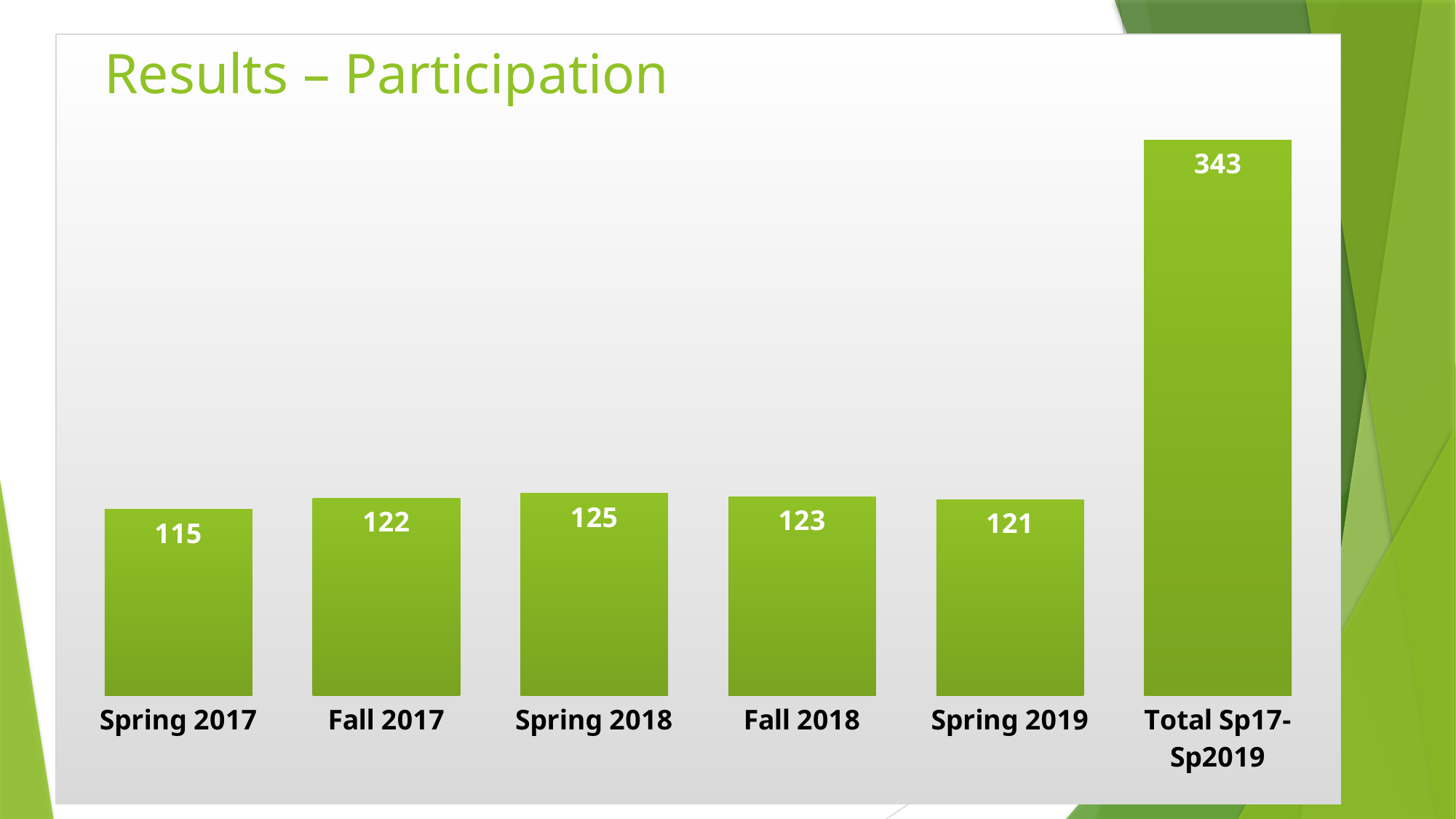
Which is larger, the value for Fall 2017 or the value for Spring 2019? Fall 2017 What is the value for Spring 2019? 121 How many bars are shown in the chart? 6 What is the difference between the values for Spring 2018 and Spring 2017? 10 What kind of chart is shown on the slide? Bar chart Which category has the lowest value? Spring 2017 What is the value for Spring 2017? 115 Which category has the highest value? Total Sp17-Sp2019 What is the value for Fall 2017? 122 What is the value for Spring 2018? 125 What is the value for Fall 2018? 123 What is the value for Total Sp17-Sp2019? 343